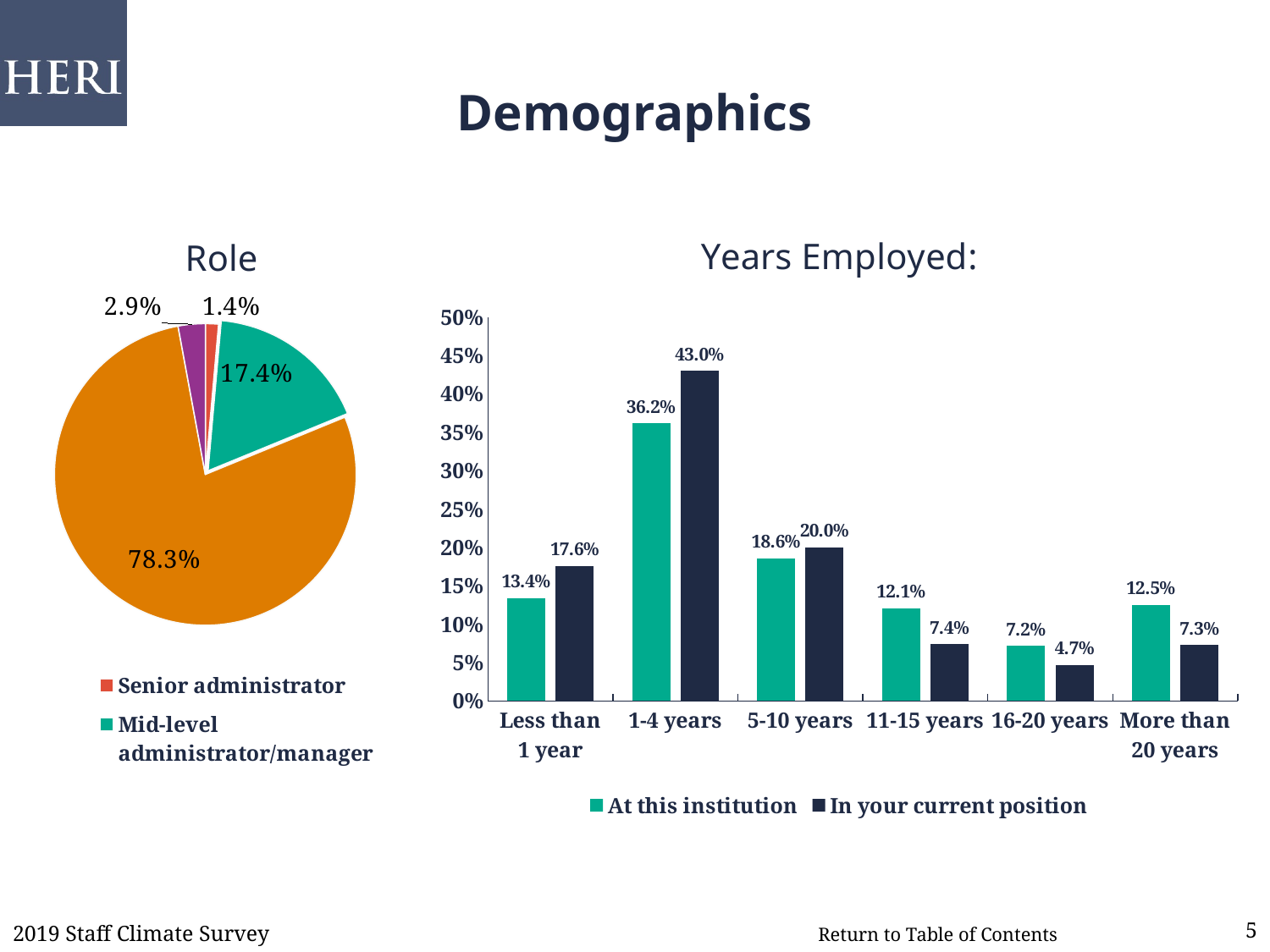
In the Years Employed chart, what percentage of respondents have been at this institution for 1-4 years? 36.2% In the Years Employed chart, how many series does the legend list? 2 What kind of chart is the Years Employed chart? Bar chart In the Years Employed chart, which category has the lowest value for 'At this institution'? 16-20 years In the Years Employed chart, what is the value for 'In your current position' for the 5-10 years category? 20.0% In the Years Employed chart, how many year-range categories are shown on the x axis? 6 In the Role pie chart, what share of respondents are Mid-level administrator/manager? 17.4% In the Years Employed chart, for the 11-15 years category, which series has the larger value: 'At this institution' or 'In your current position'? At this institution What kind of chart is the Role chart? Pie chart In the Years Employed chart, what is the difference between the 'In your current position' and 'At this institution' values for Less than 1 year? 4.2% In the Years Employed chart, which category has the highest value for 'In your current position'? 1-4 years In the Role pie chart, what share of respondents are Senior administrator? 1.4%